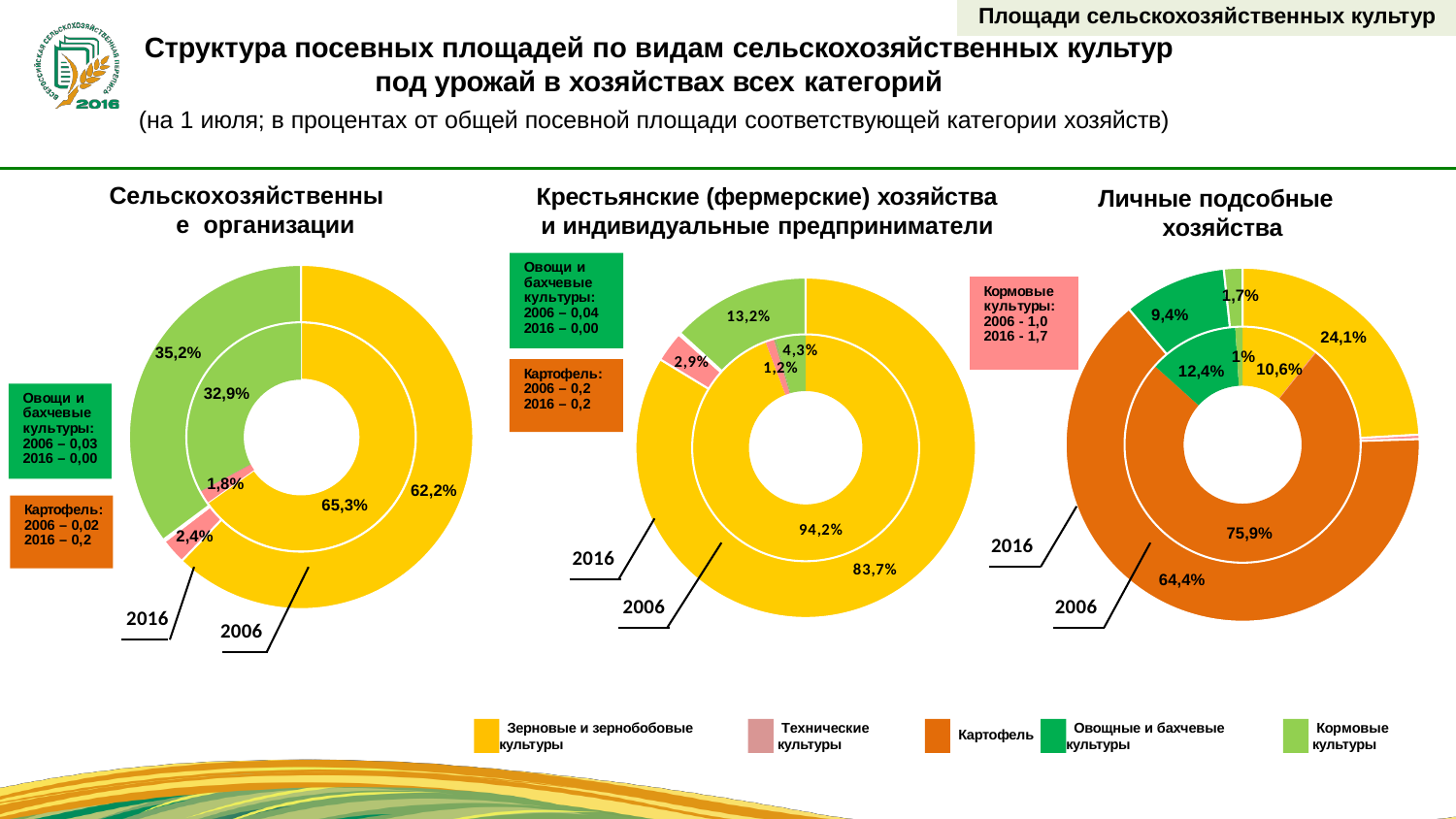
In the 'Личные подсобные хозяйства' chart, what is the largest share in the 2006 ring? 64,4% In the 'Личные подсобные хозяйства' chart, which is larger in the 2016 ring: the green slice (12,4%) or the yellow slice (10,6%)? The green slice (12,4%) In the 'Личные подсобные хозяйства' chart, what is the difference between the largest share in 2016 (75,9%) and in 2006 (64,4%)? 11,5 percentage points In the 'Сельскохозяйственные организации' chart, what is the largest share shown in the outer (2006) ring? 62,2% In the 'Крестьянские (фермерские) хозяйства и индивидуальные предприниматели' chart, what is the share of the light-green slice in the 2006 ring? 13,2% In the 'Крестьянские (фермерские) хозяйства и индивидуальные предприниматели' chart, by how many percentage points did the largest (yellow) share change from 2006 (83,7%) to 2016 (94,2%)? 10,5 percentage points What kind of charts are shown on the slide? Doughnut (pie) charts In the 'Крестьянские (фермерские) хозяйства и индивидуальные предприниматели' chart, what is the largest share in the 2016 ring? 94,2% In the 'Сельскохозяйственные организации' chart, what is the share of the light-green (кормовые культуры) slice in the 2006 ring? 35,2% How many crop categories does the legend at the bottom list? 5 In the 'Сельскохозяйственные организации' chart, what is the largest share shown in the inner (2016) ring? 65,3% How many charts are on the slide? 3